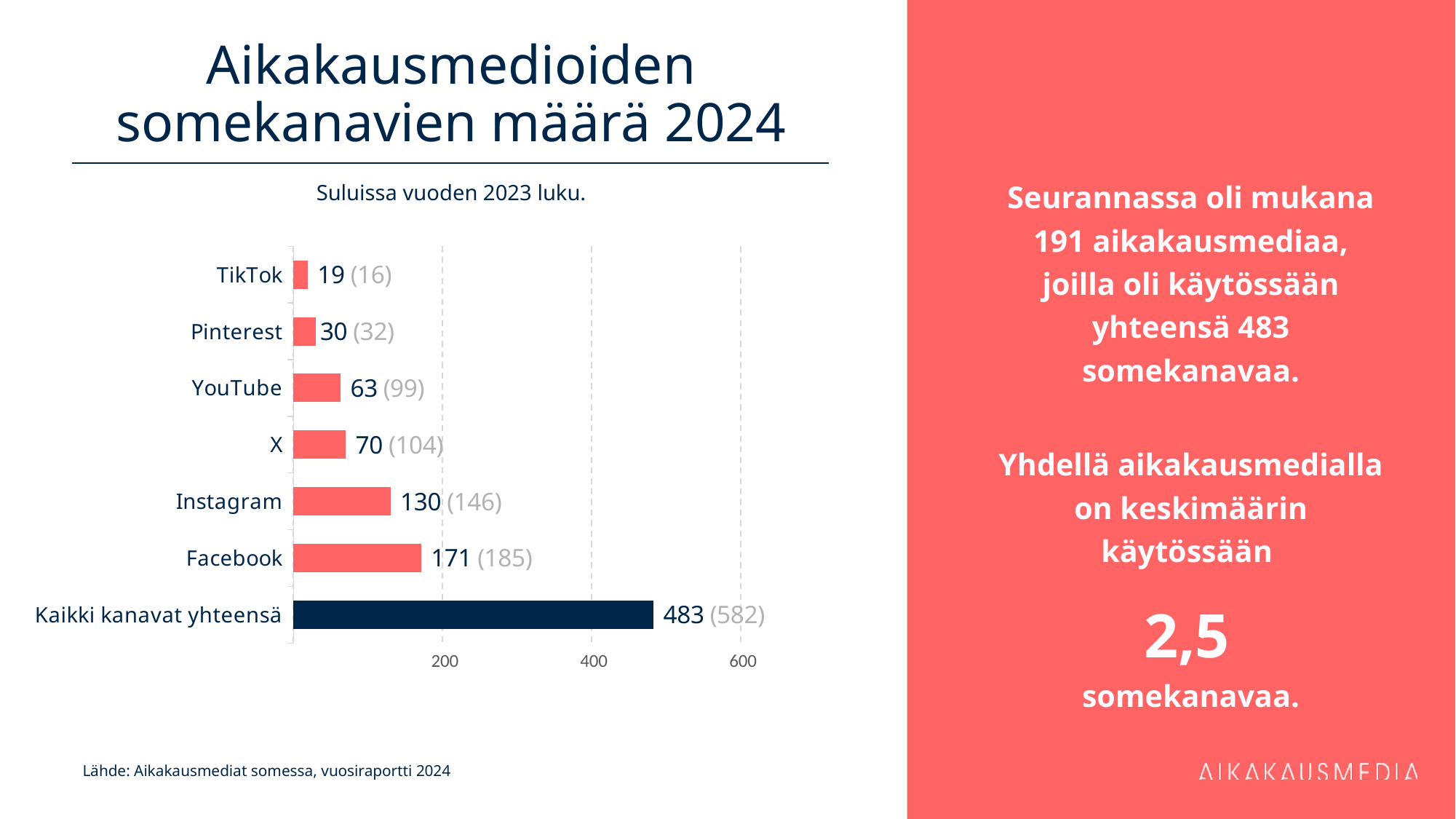
What is the difference between the 2024 values for Facebook and Instagram? 41 What is the value for Kaikki kanavat yhteensä in 2024? 483 What kind of chart is shown on the slide? Bar chart What is the title of the slide's chart? Aikakausmedioiden somekanavien määrä 2024 Which channel has the lowest 2024 value? TikTok What is the 2024 value for TikTok? 19 How many categories are shown in the chart? 7 What is the 2024 value for Facebook? 171 What was the 2023 value (in parentheses) for YouTube? 99 By how much did the total number of channels (Kaikki kanavat yhteensä) fall from 2023 to 2024? 99 Which has a larger 2024 value, X or YouTube? X Which individual channel (excluding the total) has the highest 2024 value? Facebook